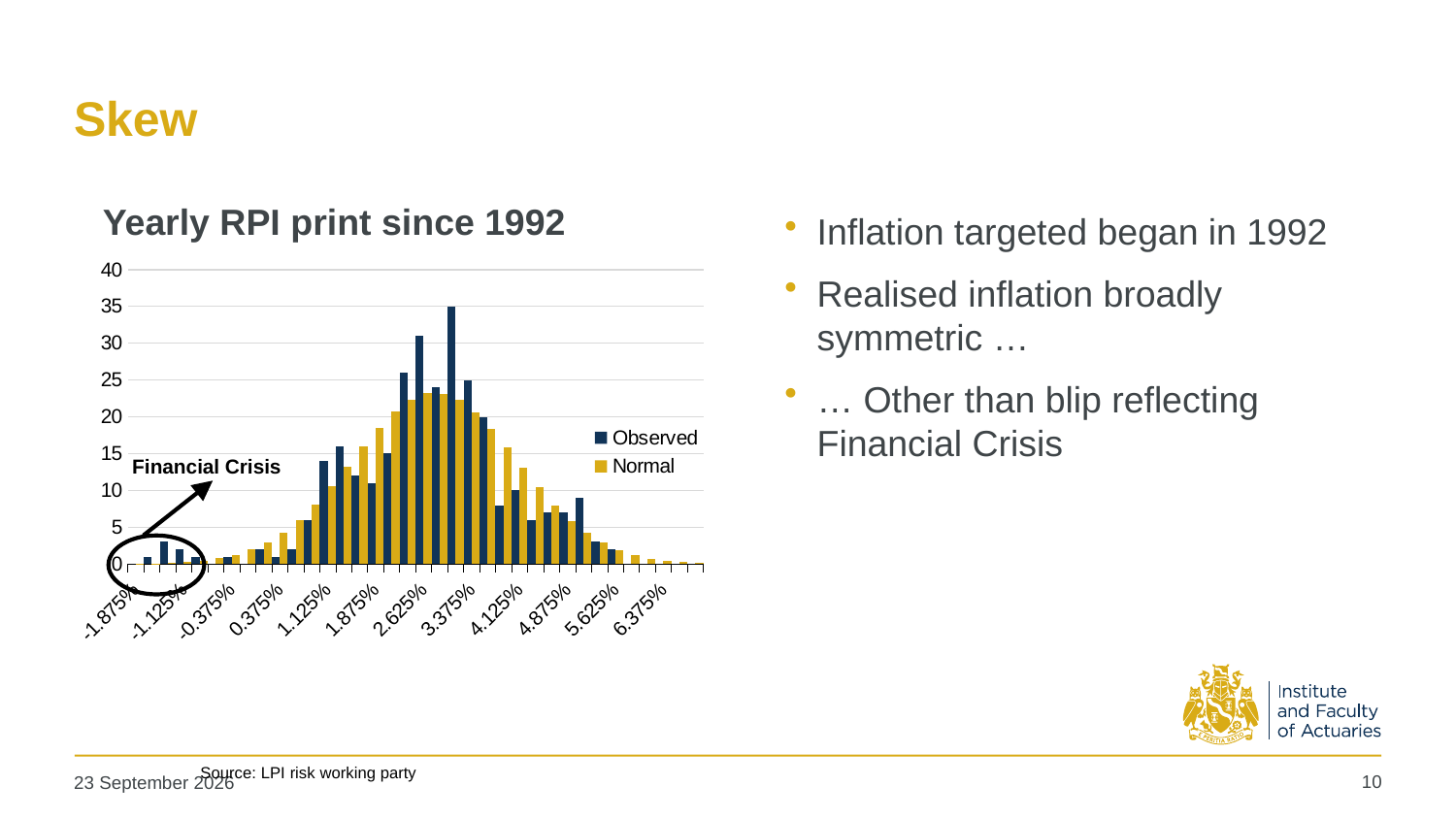
Do the Normal bars rise or fall moving from 4.125% to 6.375% along the x axis? fall What is the highest value shown on the chart's vertical axis? 40 Which series contains the tallest bar on the chart, Observed or Normal? Observed Is the Normal bar at 6.375% greater or less than 5? less Is the Observed bar at -1.875% greater or less than 5? less Is the tallest Observed bar greater or less than 30? greater What is the title of the chart? Yearly RPI print since 1992 What are the two series named in the chart's legend? Observed and Normal How many category labels are printed along the chart's horizontal axis? 12 Do the Normal bars rise or fall moving from 0.375% to 2.625% along the x axis? rise How many series does the chart's legend list? 2 What kind of chart is shown on the slide? Bar chart